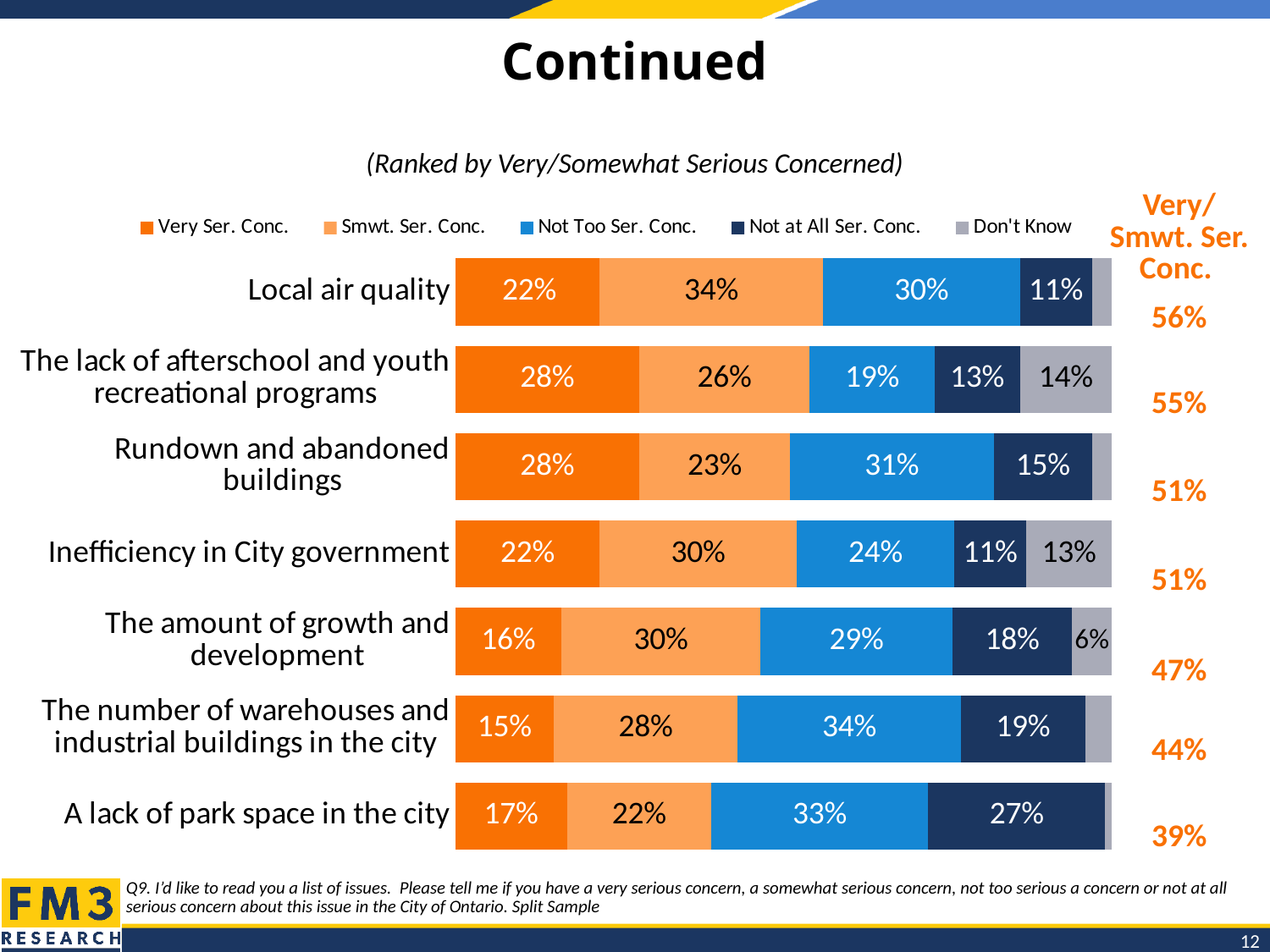
What type of chart is shown on the slide? Stacked bar chart How many response categories does the legend list? 5 How many issues are shown in the chart? 7 What is the Don't Know percentage for The lack of afterschool and youth recreational programs? 14% What percentage of respondents are Not at All Seriously Concerned about A lack of park space in the city? 27% What is the difference in Very Serious Concern percentage between The lack of afterschool and youth recreational programs and The amount of growth and development? 12 percentage points Which issue has the highest Not at All Serious Concern percentage? A lack of park space in the city Which issue has the highest Very/Somewhat Serious Concern percentage? Local air quality Which issue has the lowest Very/Somewhat Serious Concern percentage? A lack of park space in the city What is the combined Very/Somewhat Serious Concern percentage for The amount of growth and development? 47% What percentage of respondents have a Very Serious Concern about Local air quality? 22% Which has a larger Somewhat Serious Concern percentage: Local air quality or Inefficiency in City government? Local air quality